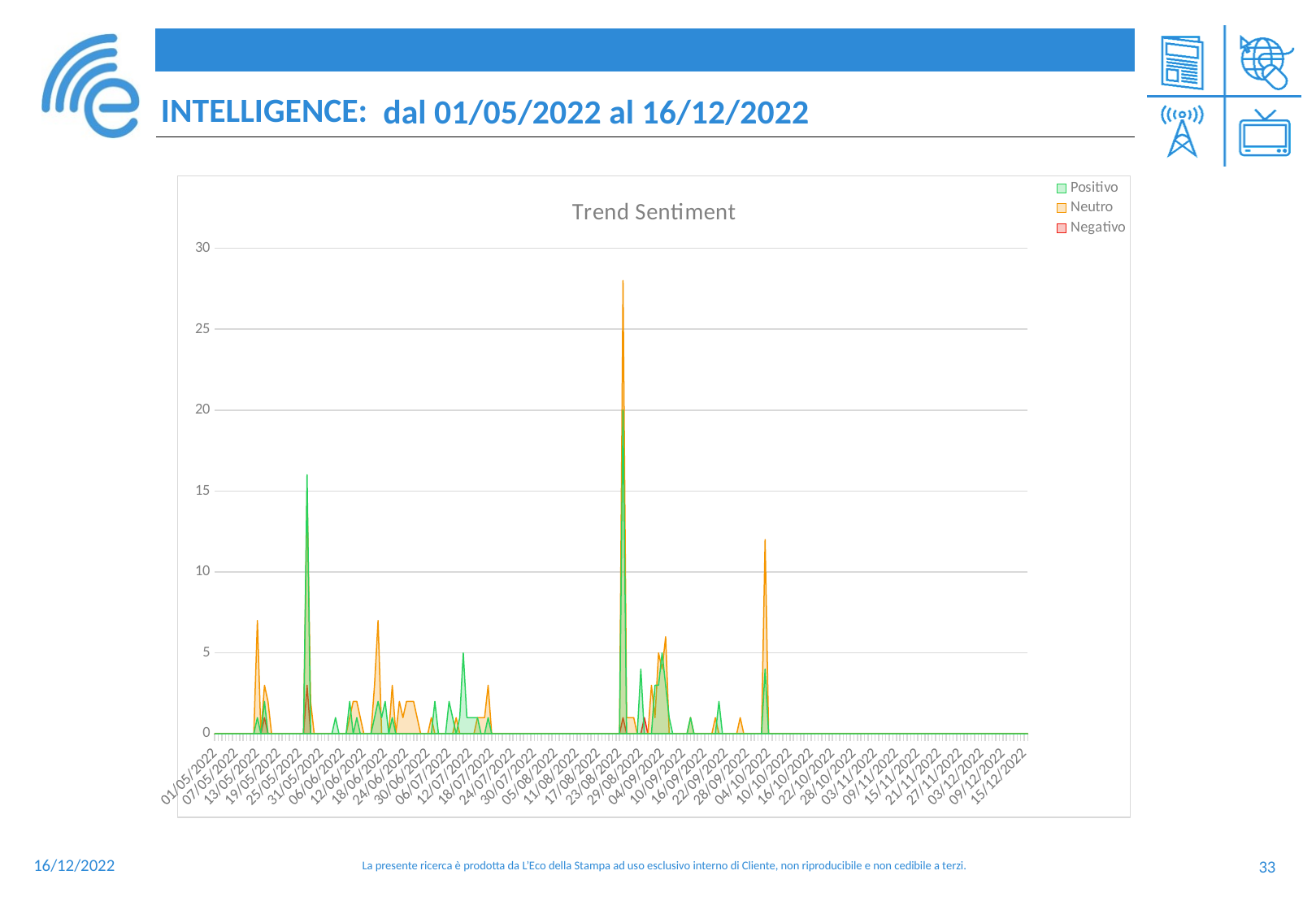
What is the highest value shown on the vertical axis of the Trend Sentiment chart? 30 Is the Neutro peak near 04/10/2022 in the Trend Sentiment chart greater or less than 15? less Is the highest peak of the Positivo series in the Trend Sentiment chart greater or less than 10? greater Is the Neutro peak near 04/10/2022 in the Trend Sentiment chart greater or less than 10? greater Which series has the higher peak in the Trend Sentiment chart, Positivo or Negativo? Positivo How many series does the legend of the Trend Sentiment chart list? 3 What is the title of the chart on the slide? Trend Sentiment Which series reaches the highest peak in the Trend Sentiment chart? Neutro What are the three series named in the legend of the Trend Sentiment chart? Positivo, Neutro, Negativo What kind of chart is the Trend Sentiment chart? Area chart